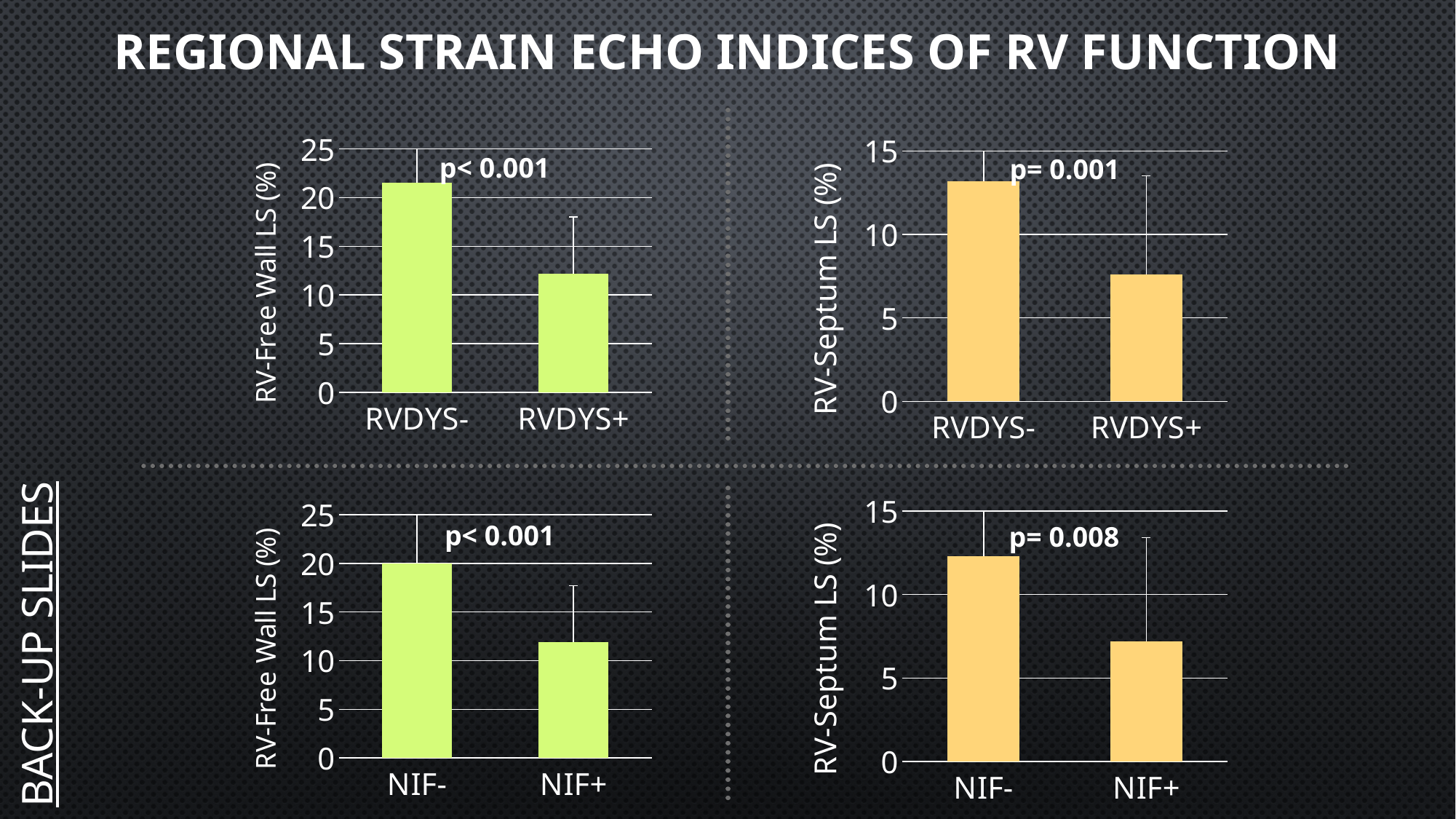
In the top-left chart (RV-Free Wall LS, RVDYS), is the value for RVDYS- greater or less than 20? greater How many categories are shown on the x axis of the bottom-right chart (RV-Septum LS, NIF)? 2 What type of chart is the top-left chart (RV-Free Wall LS, RVDYS)? bar chart In the top-left chart (RV-Free Wall LS, RVDYS), is the value for RVDYS+ greater or less than 10? greater In the top-right chart (RV-Septum LS, RVDYS), is the value for RVDYS- greater or less than 10? greater In the top-right chart (RV-Septum LS, RVDYS), which category has the lower bar? RVDYS+ In the top-left chart (RV-Free Wall LS, RVDYS), which category has the higher bar? RVDYS- In the bottom-left chart (RV-Free Wall LS, NIF), which is larger, NIF- or NIF+? NIF-